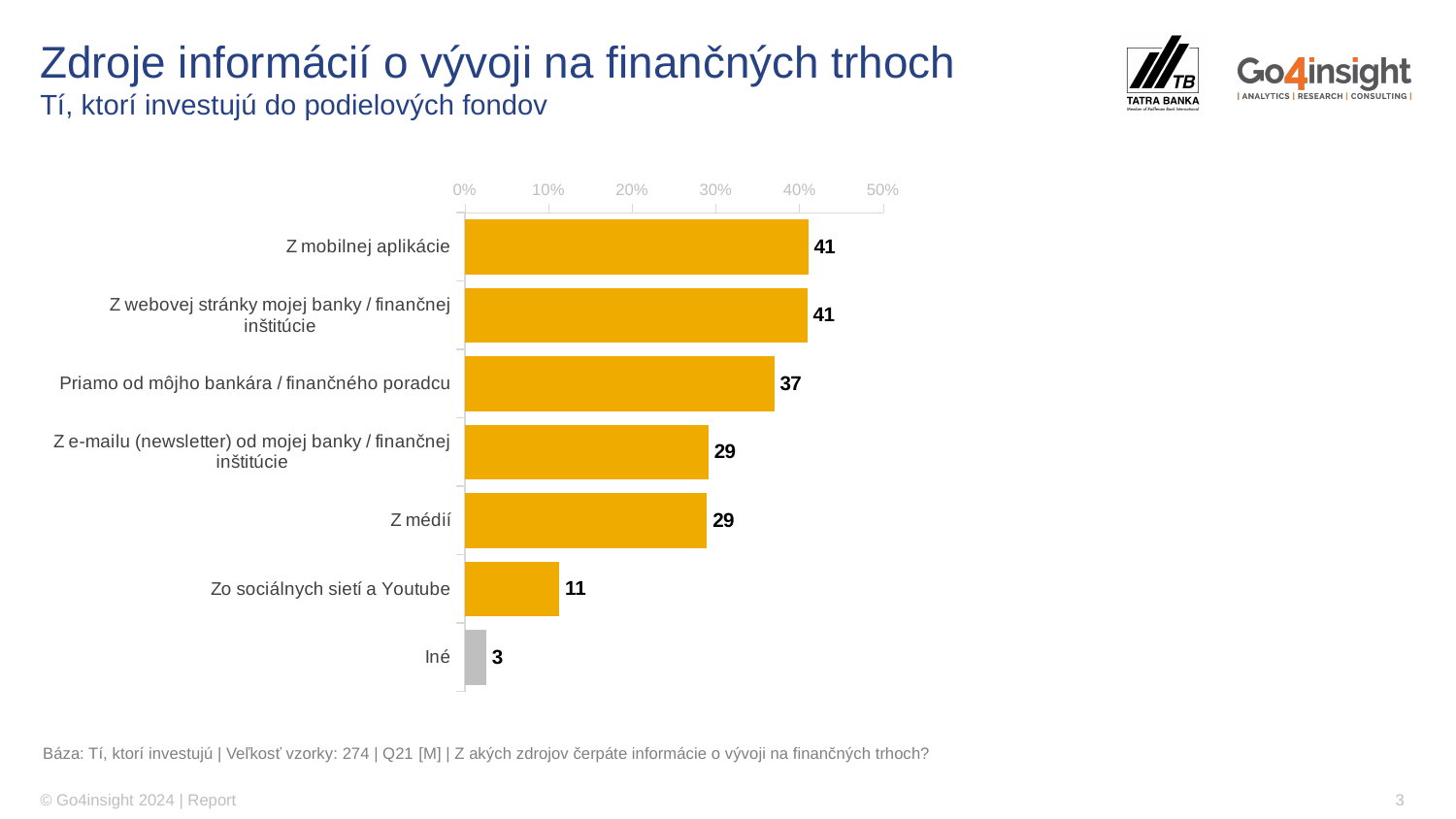
What is the title of the chart on the slide? Zdroje informácií o vývoji na finančných trhoch Which category has the lowest value? Iné Which is larger: the value for "Z webovej stránky mojej banky / finančnej inštitúcie" or the value for "Z e-mailu (newsletter) od mojej banky / finančnej inštitúcie"? Z webovej stránky mojej banky / finančnej inštitúcie What is the value for "Priamo od môjho bankára / finančného poradcu"? 37 What is the difference between the values for "Z mobilnej aplikácie" and "Z médií"? 12 What is the value for "Z mobilnej aplikácie"? 41 What is the value for "Zo sociálnych sietí a Youtube"? 11 What is the difference between the values for "Priamo od môjho bankára / finančného poradcu" and "Zo sociálnych sietí a Youtube"? 26 How many categories are shown in the chart? 7 What kind of chart is shown on the slide? bar chart Is the value for "Z médií" greater or less than 30%? less What is the value for "Iné"? 3